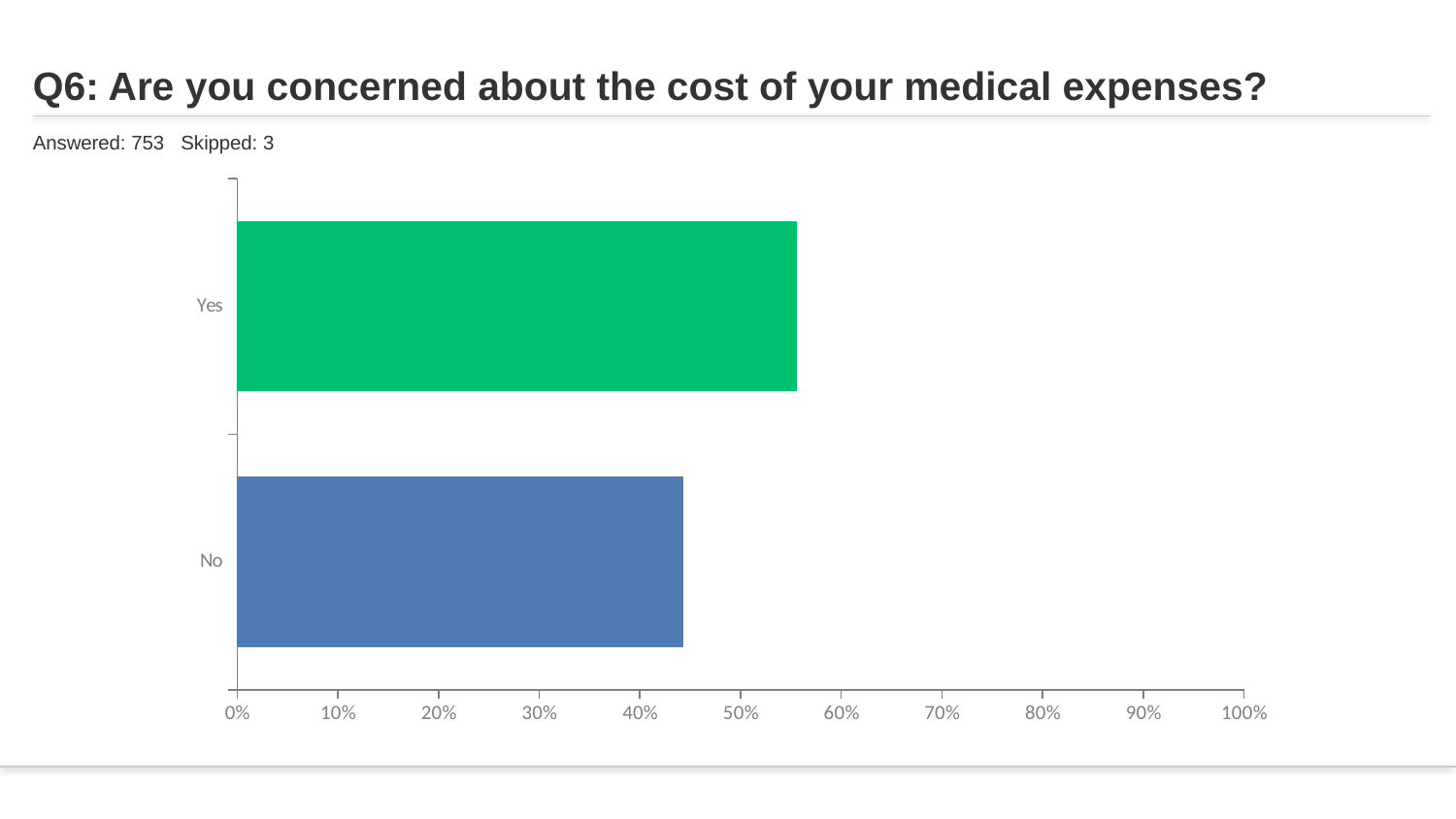
How many respondents answered the question according to the slide? 753 Which is larger, the value for Yes or the value for No? Yes How many categories are plotted in the chart? 2 Which category has the lowest value? No Which category has the highest value? Yes Is the value for Yes greater or less than 60%? less Is the value for No greater or less than 40%? greater What is the title of the chart? Q6: Are you concerned about the cost of your medical expenses? Is the value for No greater or less than 50%? less What kind of chart is shown on the slide? bar chart